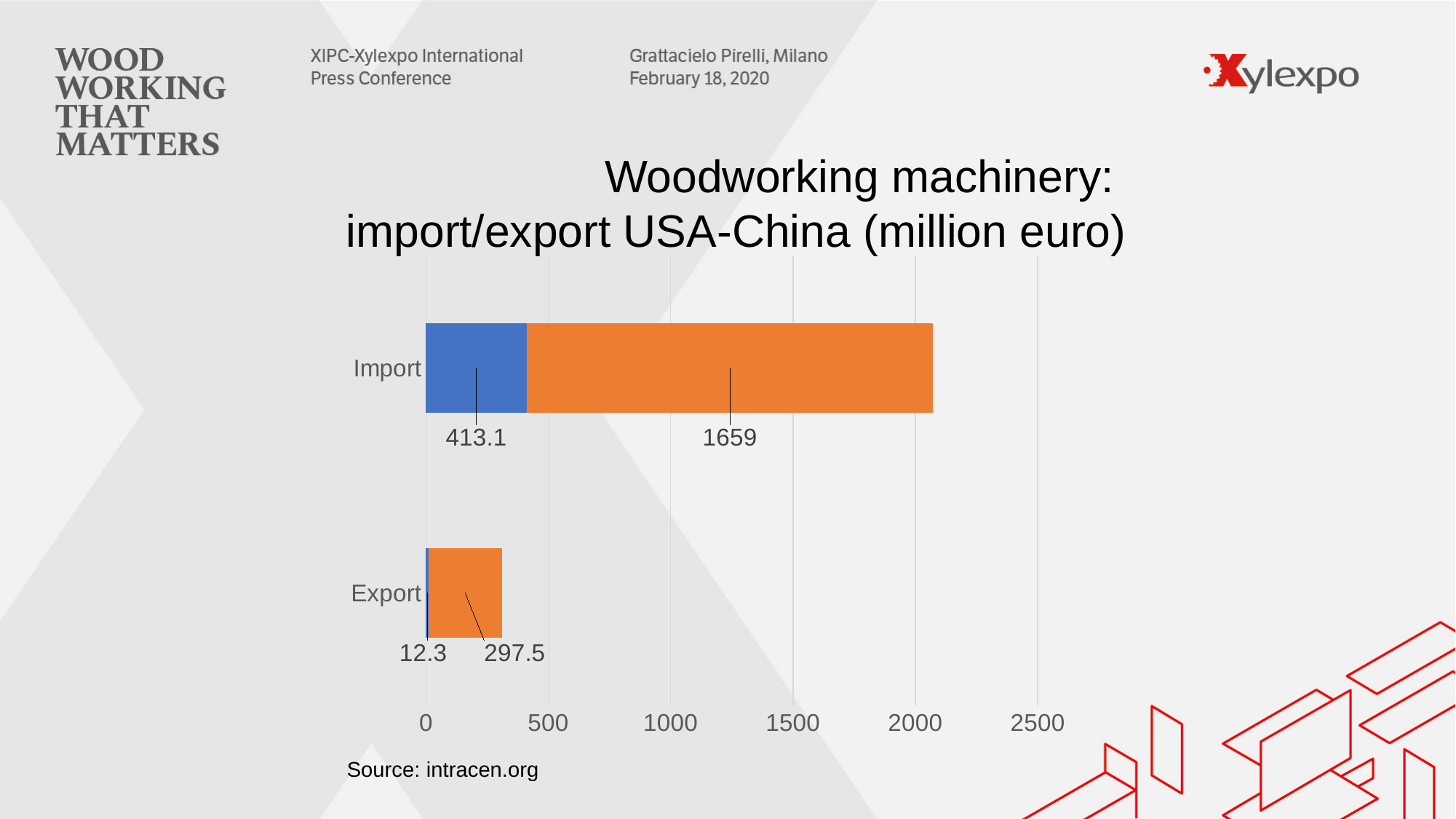
What is the value of the blue segment of the Import bar? 413.1 What is the value of the orange segment of the Import bar? 1659 What is the difference between the orange and blue segments of the Import bar? 1245.9 What is the total of the stacked Import bar? 2072.1 Which category has the longer total bar, Import or Export? Import What is the total of the stacked Export bar? 309.8 What is the value of the blue segment of the Export bar? 12.3 How many categories are shown on the chart? 2 Is the total length of the Import bar greater or less than 2000? greater What kind of chart is shown on the slide? Stacked bar chart What is the value of the orange segment of the Export bar? 297.5 What is the difference between the orange segment of the Import bar and the orange segment of the Export bar? 1361.5